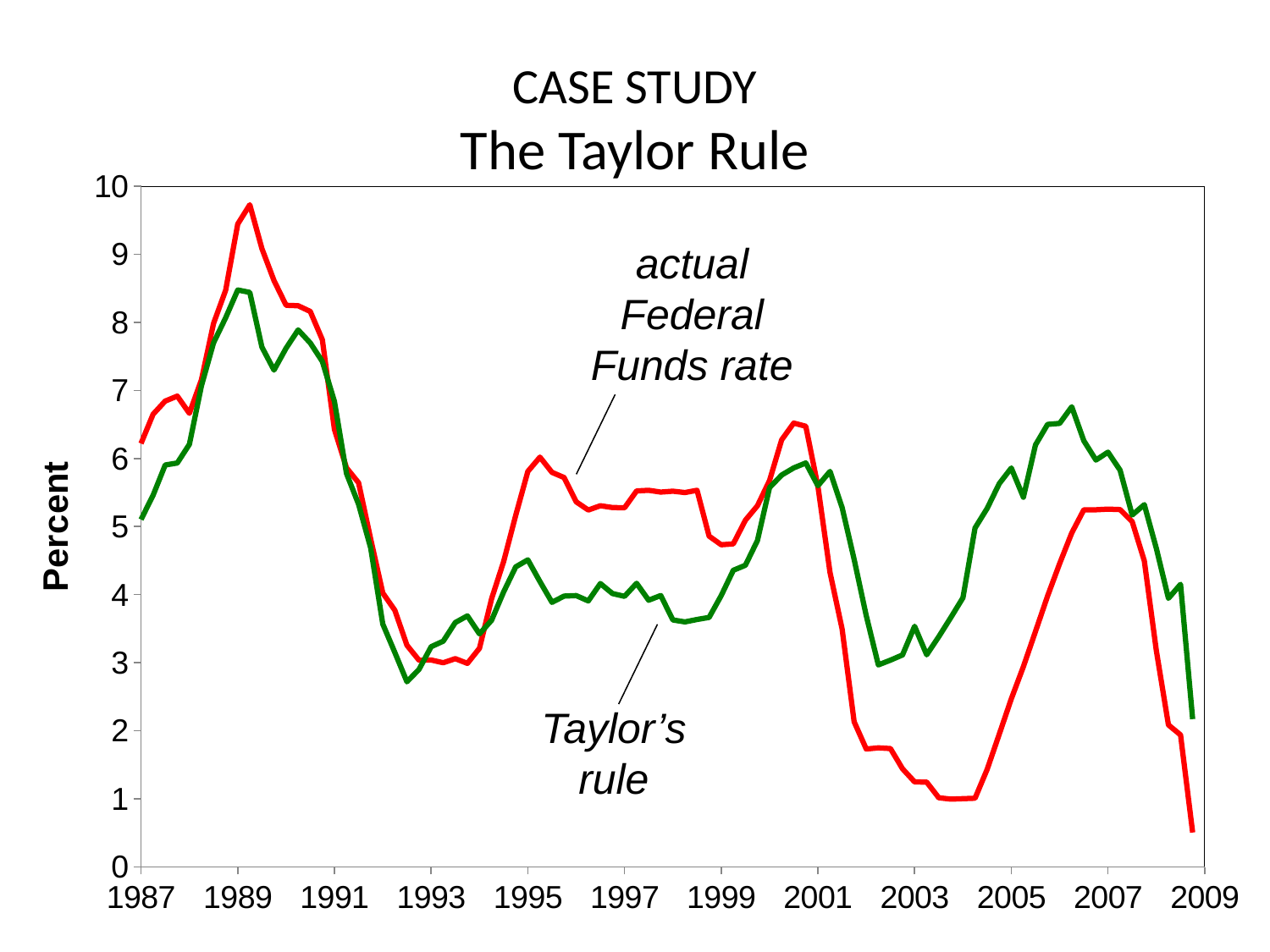
Is the Taylor's rule value in 2004 greater or less than 3? greater In 1989, which series is higher: the actual Federal Funds rate or Taylor's rule? actual Federal Funds rate Is the actual Federal Funds rate in 2004 greater or less than 2? less What kind of chart is shown on the slide? line chart What is the label on the vertical axis? Percent Is the Taylor's rule value in 2006 greater or less than 6? greater Which series reaches the highest value anywhere on the chart? actual Federal Funds rate Does the actual Federal Funds rate rise or fall between 2007 and 2009? fall What is the title of the chart? The Taylor Rule How many series are plotted on the chart? 2 In 2004, which series is higher: the actual Federal Funds rate or Taylor's rule? Taylor's rule